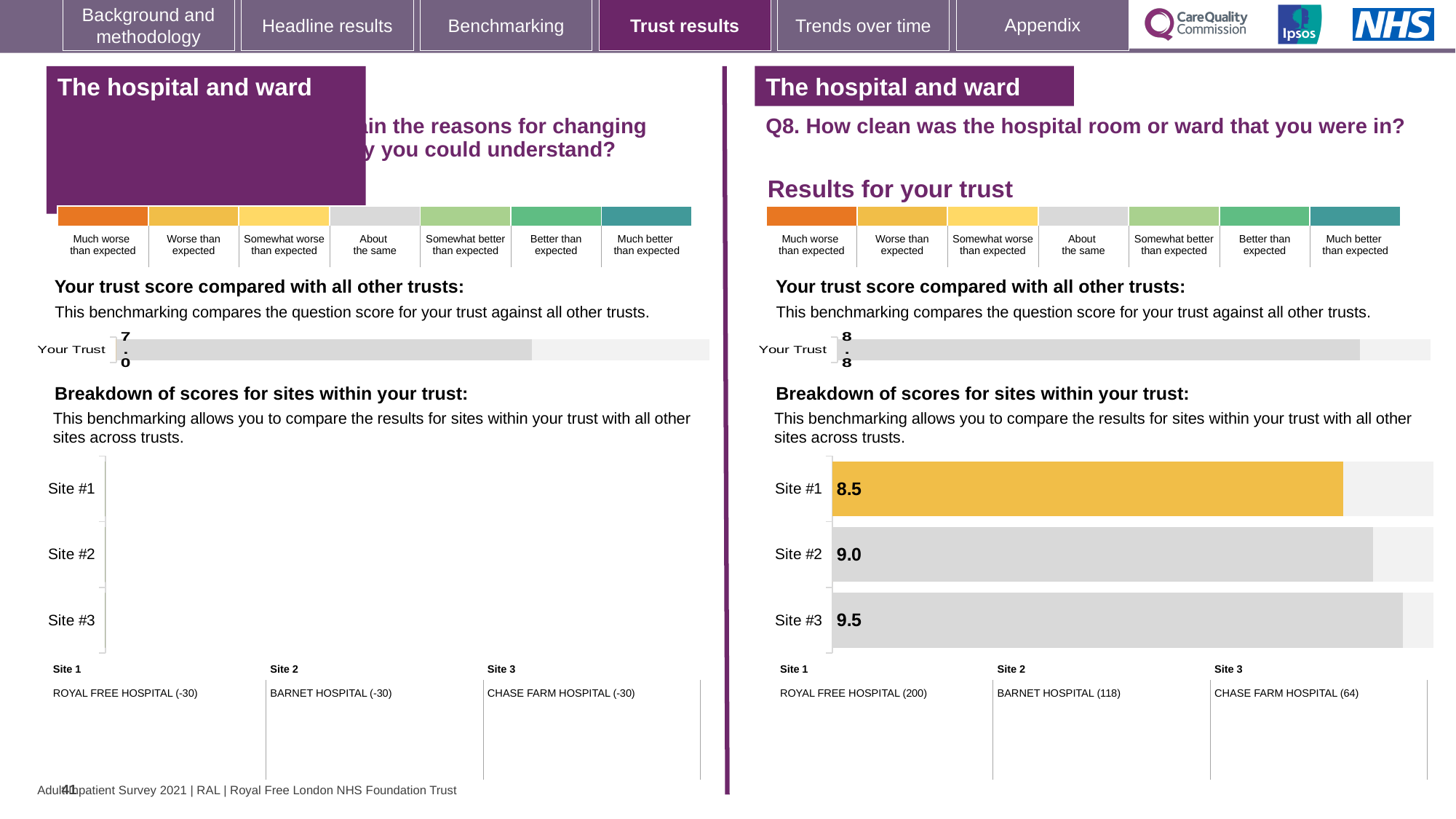
On the left-hand 'Your trust score compared with all other trusts' chart, what is the score for Your Trust? 7.0 On the right-hand site breakdown chart (Q8), what is the score for Site #2? 9.0 What type of chart is the right-hand site breakdown chart (Q8)? Bar chart On the right-hand site breakdown chart (Q8), which site has the lowest score? Site #1 On the right-hand site breakdown chart (Q8), which site has the highest score? Site #3 On the right-hand site breakdown chart (Q8), which has the larger score, Site #1 or Site #2? Site #2 How many sites are shown on the right-hand site breakdown chart (Q8)? 3 On the right-hand site breakdown chart (Q8), what is the difference between the scores for Site #3 and Site #1? 1.0 On the right-hand site breakdown chart (Q8), what is the score for Site #1? 8.5 On the right-hand site breakdown chart (Q8), do the scores rise or fall going from Site #1 down to Site #3? Rise On the right-hand 'Your trust score compared with all other trusts' chart (Q8), what is the score for Your Trust? 8.8 On the right-hand site breakdown chart (Q8), what is the score for Site #3? 9.5